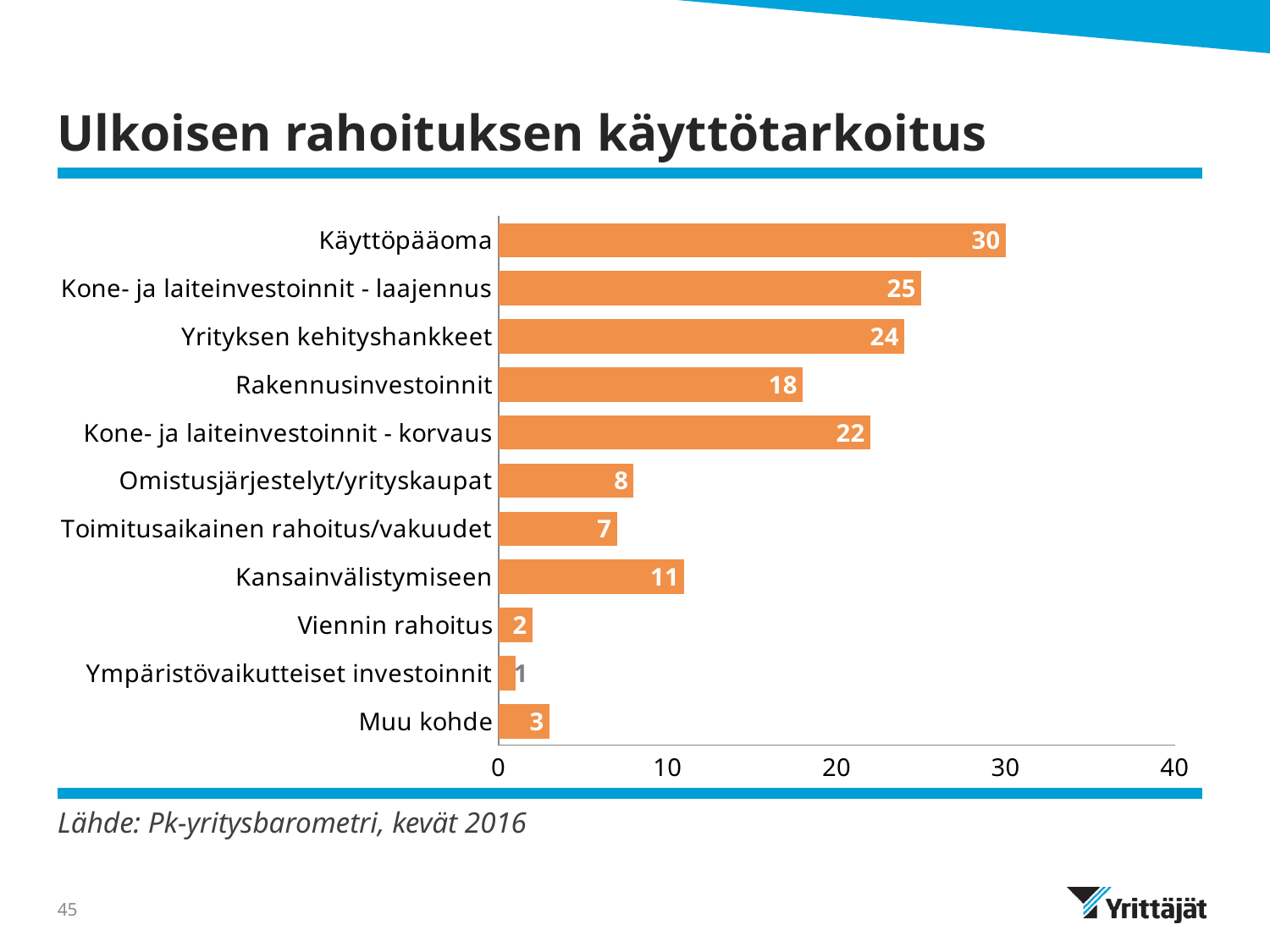
What kind of chart is shown on the slide? bar chart What is the difference between the values for Kone- ja laiteinvestoinnit - laajennus and Kone- ja laiteinvestoinnit - korvaus? 3 Which category has the highest value? Käyttöpääoma What is the title of the slide? Ulkoisen rahoituksen käyttötarkoitus Which is larger, the value for Omistusjärjestelyt/yrityskaupat or the value for Toimitusaikainen rahoitus/vakuudet? Omistusjärjestelyt/yrityskaupat Which category has the lowest value? Ympäristövaikutteiset investoinnit What is the value for Rakennusinvestoinnit? 18 What is the value for Käyttöpääoma? 30 What is the value for Kansainvälistymiseen? 11 What is the value for Muu kohde? 3 How many categories are shown in the chart? 11 Is the value for Yrityksen kehityshankkeet greater or less than 20? greater